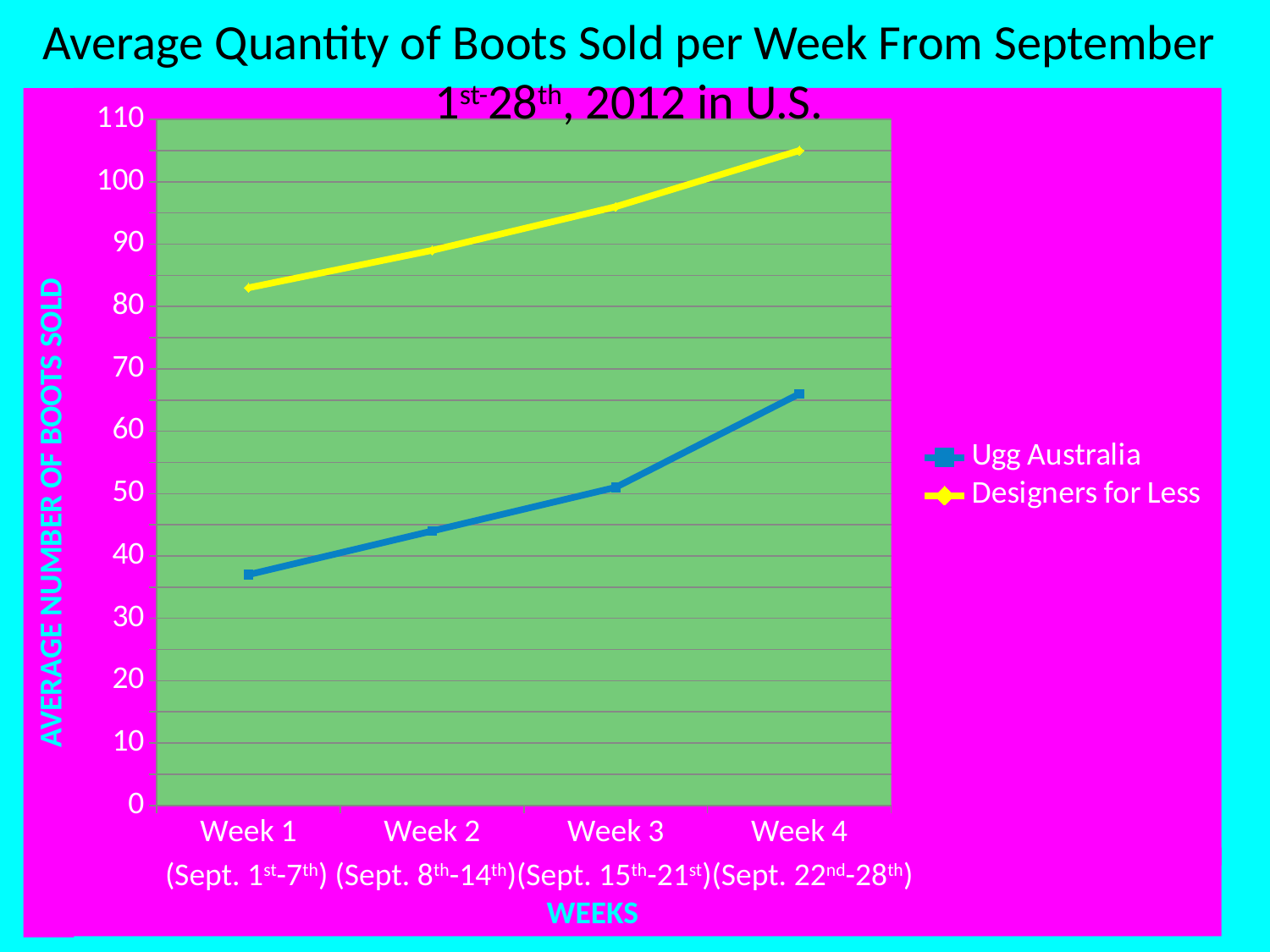
Is the value for Ugg Australia in Week 4 greater or less than 60? greater In which week is the value for Ugg Australia lowest? Week 1 How many weeks are plotted along the x axis? 4 Do the values for Designers for Less rise or fall from Week 1 to Week 4? rise Is the value for Ugg Australia in Week 1 greater or less than 40? less What kind of chart is shown on the slide? line chart How many series does the legend list? 2 Is the value for Designers for Less in Week 4 greater or less than 100? greater Which series has the higher value in Week 4, Ugg Australia or Designers for Less? Designers for Less What colour is the line for Designers for Less? yellow Do the values for Ugg Australia rise or fall from Week 1 to Week 4? rise